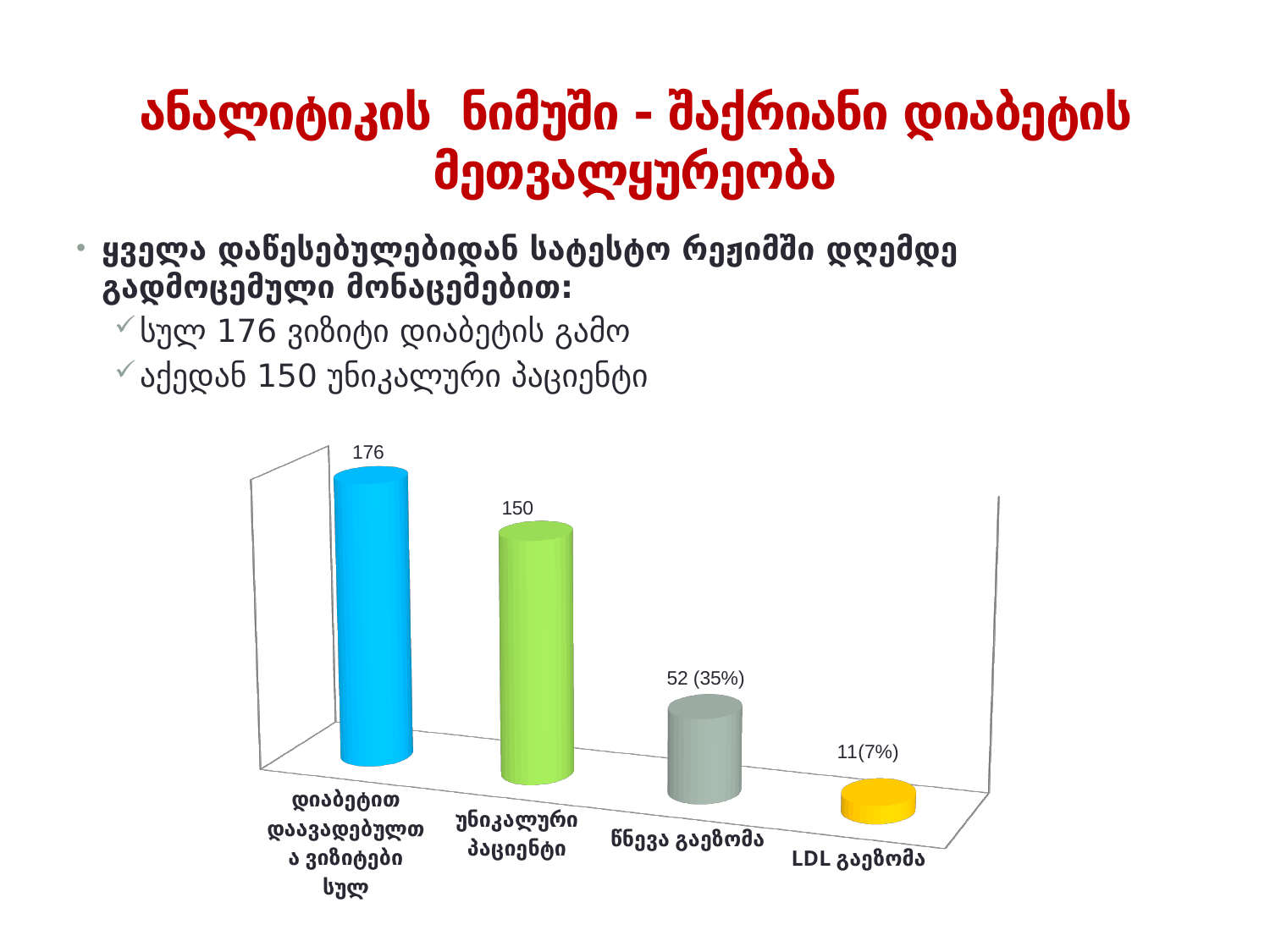
What value is shown for the bar labelled "უნიკალური პაციენტი"? 150 What data label is shown on the bar for "LDL გაეზომა"? 11(7%) What data label is shown on the bar for "წნევა გაეზომა"? 52 (35%) What is the difference between the values for "დიაბეტით დაავადებულა ვიზიტები სულ" and "უნიკალური პაციენტი"? 26 Which is larger: the value for "უნიკალური პაციენტი" or the value for "წნევა გაეზომა"? უნიკალური პაციენტი How many categories (bars) are shown in the chart? 4 Do the bar values rise or fall from left to right across the chart? Fall Which category has the lowest bar in the chart? LDL გაეზომა What is the difference between the counts for "წნევა გაეზომა" and "LDL გაეზომა"? 41 What value is shown for the first bar, "დიაბეტით დაავადებულა ვიზიტები სულ"? 176 Which category has the highest bar in the chart? დიაბეტით დაავადებულთა ვიზიტები სულ What kind of chart is shown on the slide? Bar chart